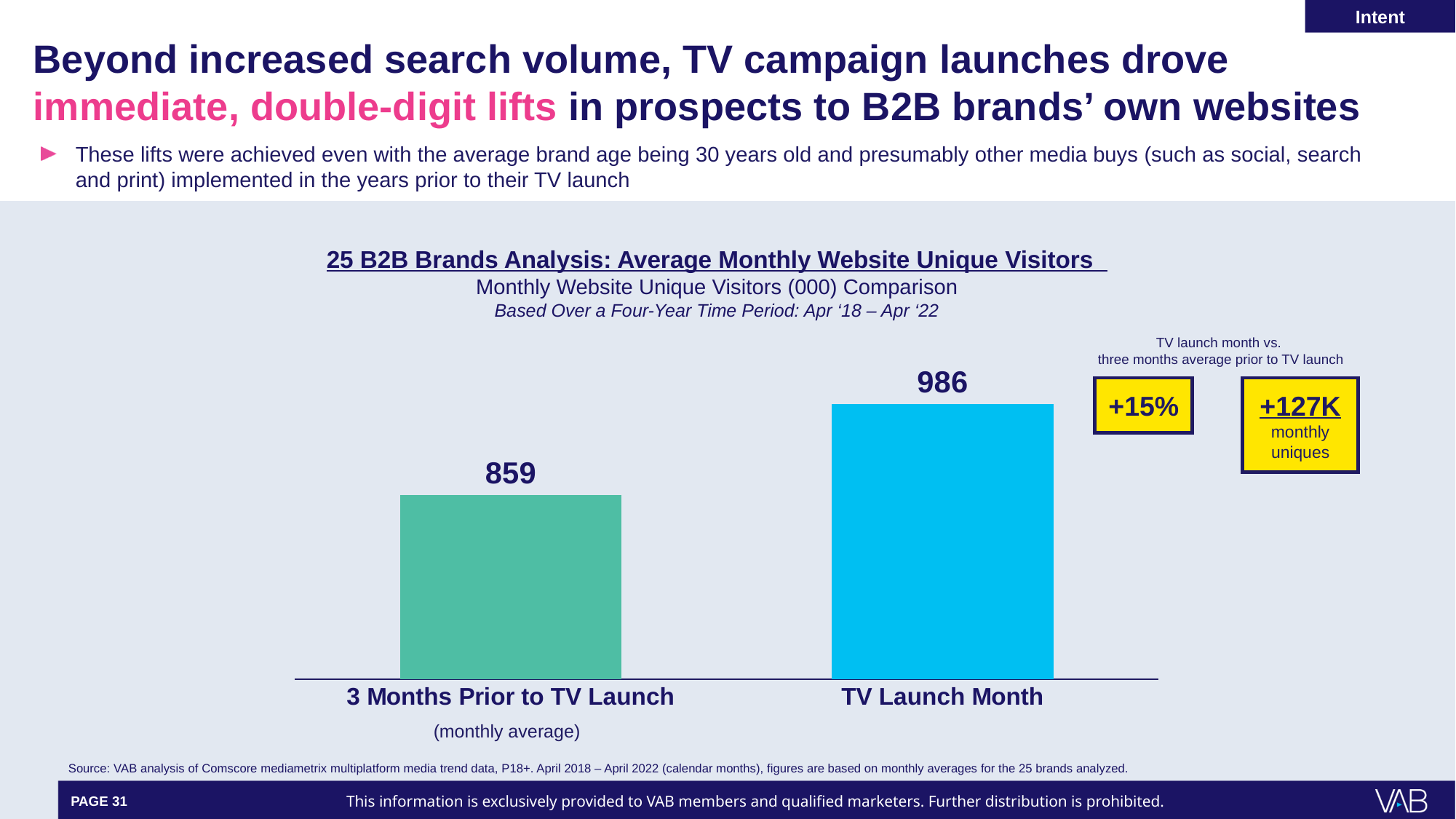
Do the values rise or fall from 3 Months Prior to TV Launch to TV Launch Month? Rise What is the underlined title of the chart? 25 B2B Brands Analysis: Average Monthly Website Unique Visitors What percentage lift is shown in the yellow box for TV launch month vs. the three months average prior to TV launch? +15% What is the value for TV Launch Month? 986 What is the value for 3 Months Prior to TV Launch? 859 Which category has the lowest value? 3 Months Prior to TV Launch What kind of chart is shown on the slide? Bar chart How many bars are shown in the chart? 2 Which is larger, the value for TV Launch Month or the value for 3 Months Prior to TV Launch? TV Launch Month What is the difference between the TV Launch Month value and the 3 Months Prior to TV Launch value? 127 Which category has the highest value? TV Launch Month